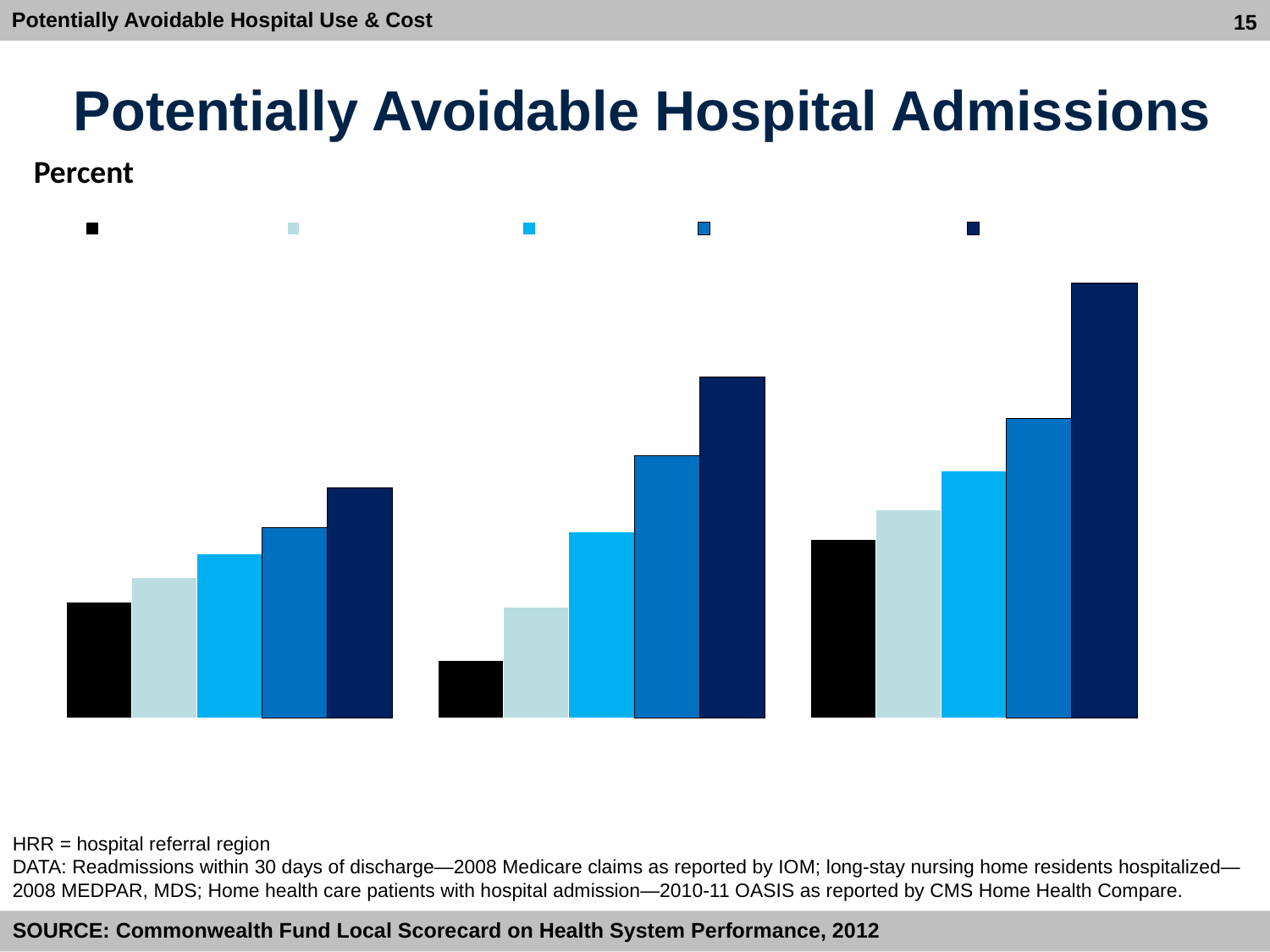
Is the black bar in the leftmost group taller or shorter than the black bar in the middle group? taller Which group of bars contains the shortest bar on the chart: the leftmost, middle, or rightmost group? middle How many groups of bars does the chart contain? 3 In the rightmost group, is the leftmost (black) bar or the rightmost (dark blue) bar taller? the rightmost (dark blue) bar Which group of bars contains the tallest bar on the chart: the leftmost, middle, or rightmost group? rightmost What unit label is shown above the chart's vertical axis? Percent What is the title of the chart? Potentially Avoidable Hospital Admissions How many series does the legend list? 5 How many bars are in each group of the chart? 5 What kind of chart is shown on the slide? bar chart Within each group, do the bars rise or fall from left to right? rise